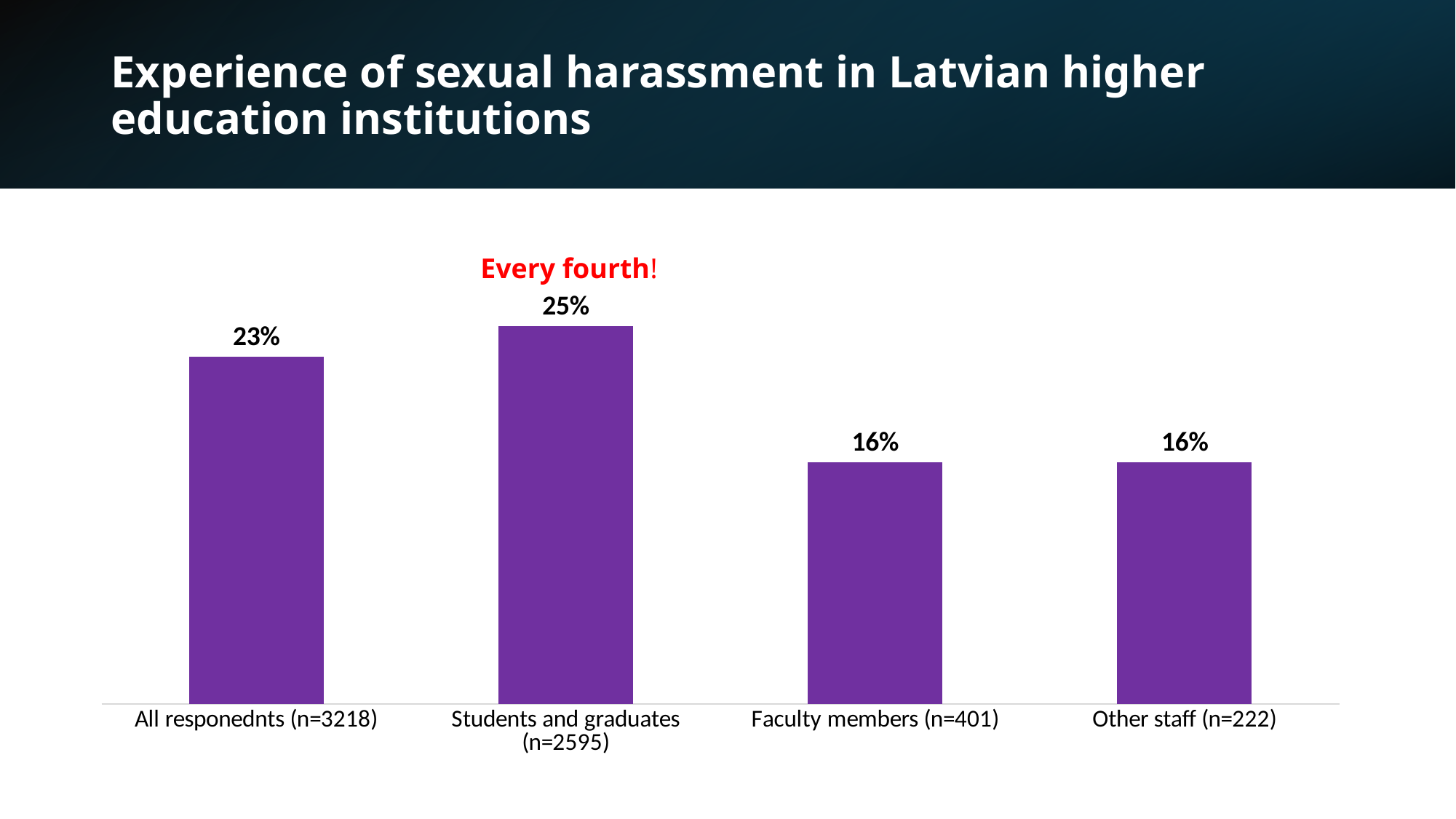
Which is larger, the value for All respondents or the value for Other staff? All respondents What is the difference between the values for Students and graduates and Faculty members? 9% What is the difference between the values for Students and graduates and All respondents? 2% What red annotation text appears above the Students and graduates bar? Every fourth! What is the value for Students and graduates (n=2595)? 25% What kind of chart is shown on the slide? Bar chart What colour are the bars in the chart? Purple What is the value for All respondents (n=3218)? 23% What is the value for Faculty members (n=401)? 16% How many categories are shown in the chart? 4 Which category has the highest value? Students and graduates (n=2595) What is the value for Other staff (n=222)? 16%